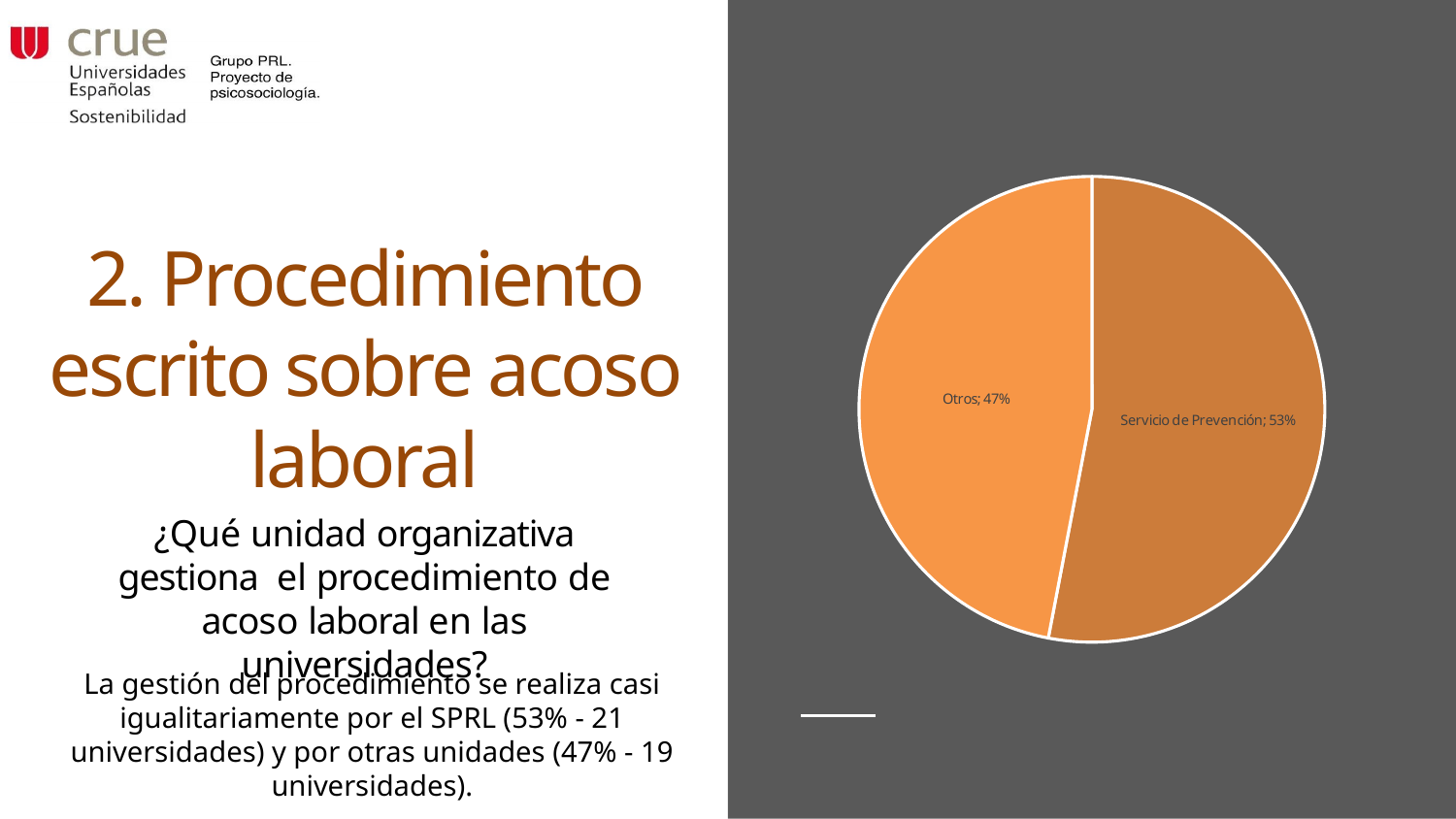
What is the value for Otros in the pie chart? 47% Which is larger, the slice for Servicio de Prevención or the slice for Otros? Servicio de Prevención Which slice of the pie chart is the smallest? Otros What is the difference in percentage points between Servicio de Prevención and Otros? 6 What is the background colour of the panel containing the pie chart? dark grey Is the value for Servicio de Prevención greater or less than 50%? greater What is the value for Servicio de Prevención in the pie chart? 53% How many slices does the pie chart have? 2 Which slice of the pie chart is the largest? Servicio de Prevención Is the value for Otros greater or less than 50%? less What kind of chart is shown on the slide? pie chart What share of the pie does Otros represent? 47%